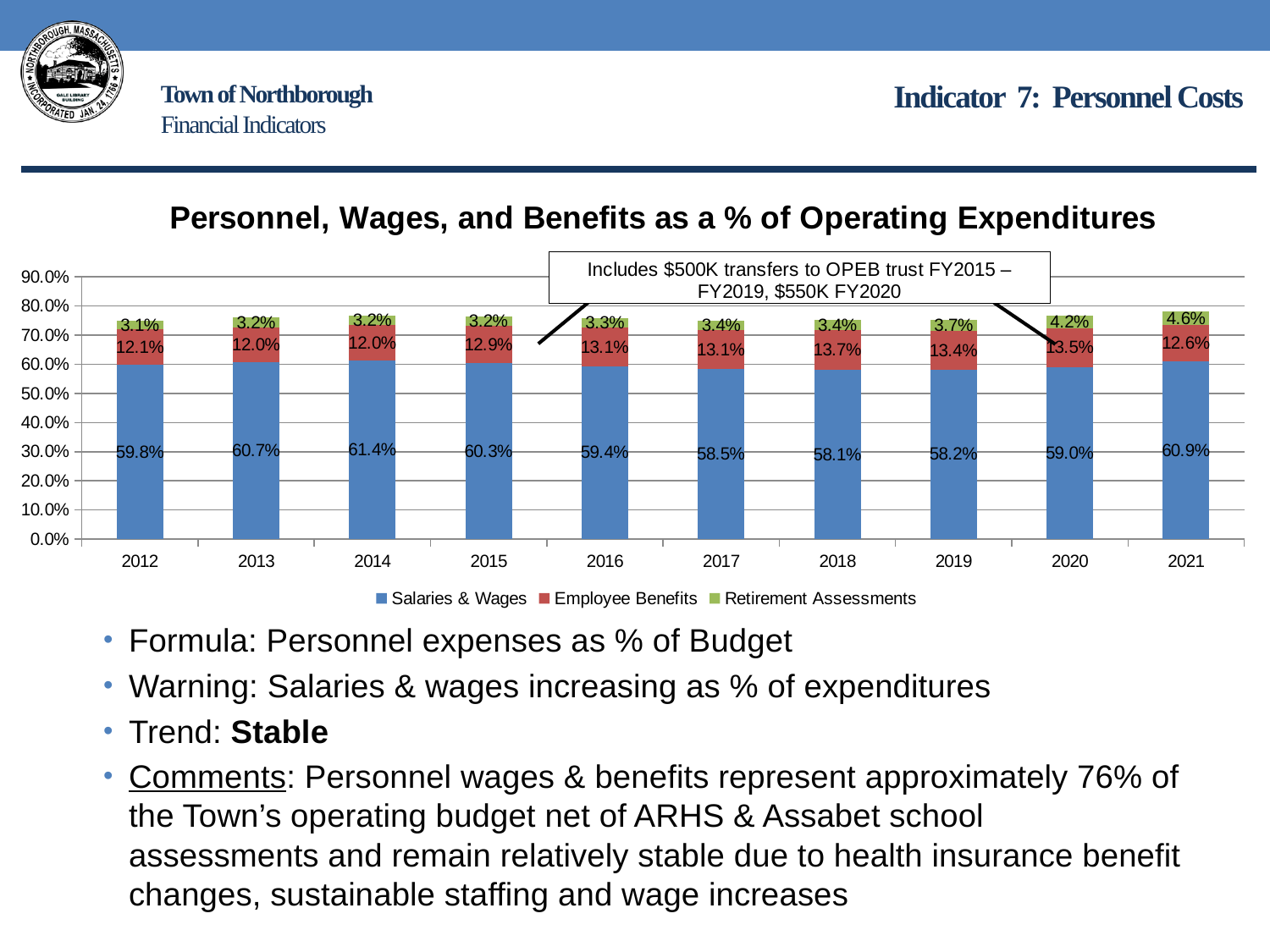
What kind of chart is shown on the slide? Stacked bar chart How many series does the legend list? 3 What is the Retirement Assessments value for 2021? 4.6% In which year is the Salaries & Wages value highest? 2014 What is the Employee Benefits value for 2018? 13.7% What is the total of the stacked bar for 2012? 75.0% How many years are shown on the x axis? 10 Which is larger, the Employee Benefits value for 2015 or for 2021? 2015 What is the Salaries & Wages value for 2014? 61.4% In which year is the Retirement Assessments value lowest? 2012 In which year is the Retirement Assessments value highest? 2021 What is the difference between the Retirement Assessments values for 2021 and 2012? 1.5 percentage points